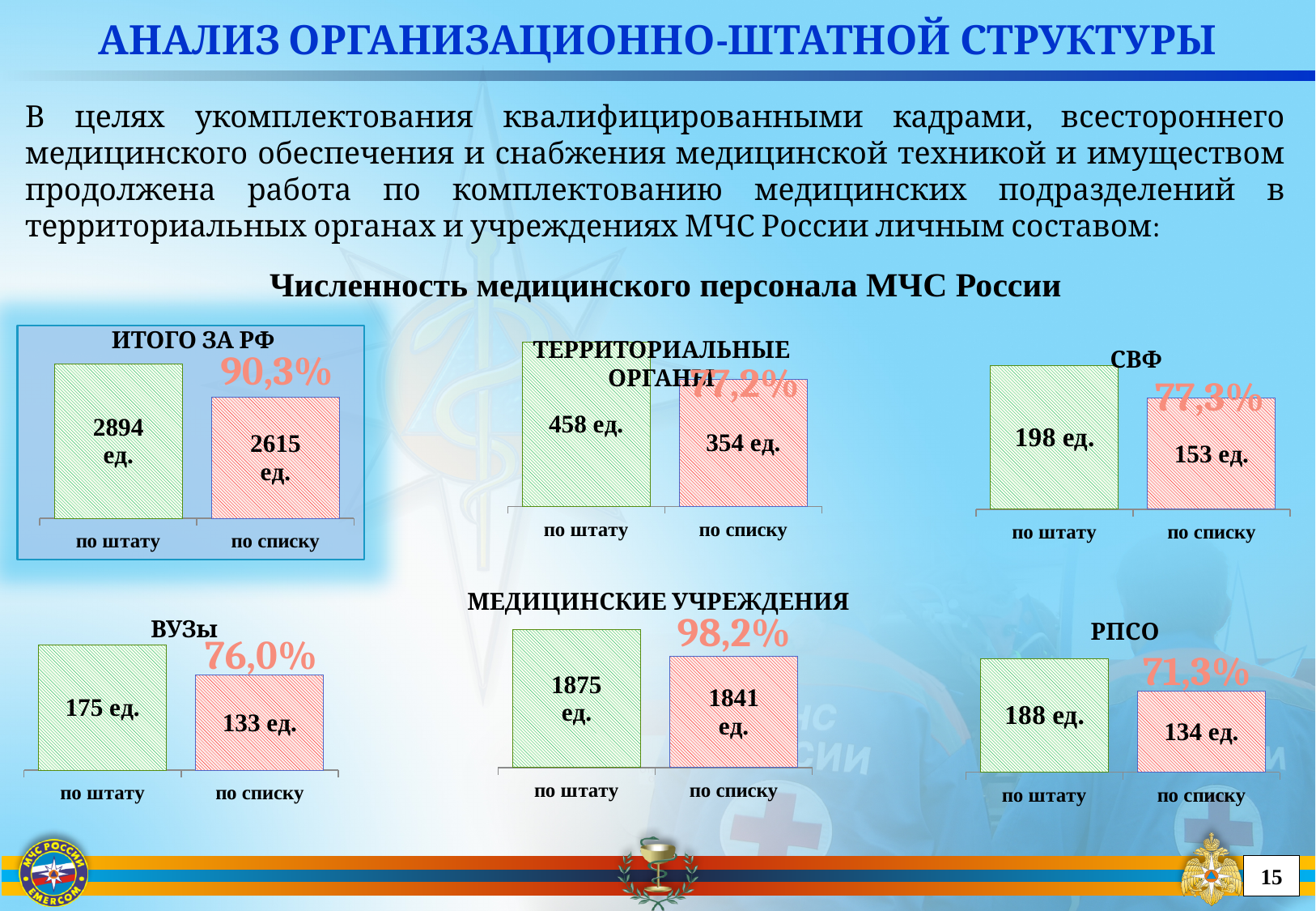
How many bars does the СВФ chart have? 2 In the ВУЗы chart, what is the difference between по штату and по списку? 42 ед. In the ТЕРРИТОРИАЛЬНЫЕ ОРГАНЫ chart, what is the difference between по штату and по списку? 104 ед. In the СВФ chart, what is the value for по штату? 198 ед. In the МЕДИЦИНСКИЕ УЧРЕЖДЕНИЯ chart, what is the value for по списку? 1841 ед. In the ИТОГО ЗА РФ chart, what is the value for по списку? 2615 ед. In the РПСО chart, which bar is higher, по штату or по списку? по штату How many separate bar charts are shown on the slide? 6 In the ИТОГО ЗА РФ chart, what is the value for по штату? 2894 ед. In the ТЕРРИТОРИАЛЬНЫЕ ОРГАНЫ chart, what is the value for по списку? 354 ед. What percentage is shown above the МЕДИЦИНСКИЕ УЧРЕЖДЕНИЯ chart? 98,2% What kind of chart is the ИТОГО ЗА РФ chart? bar chart